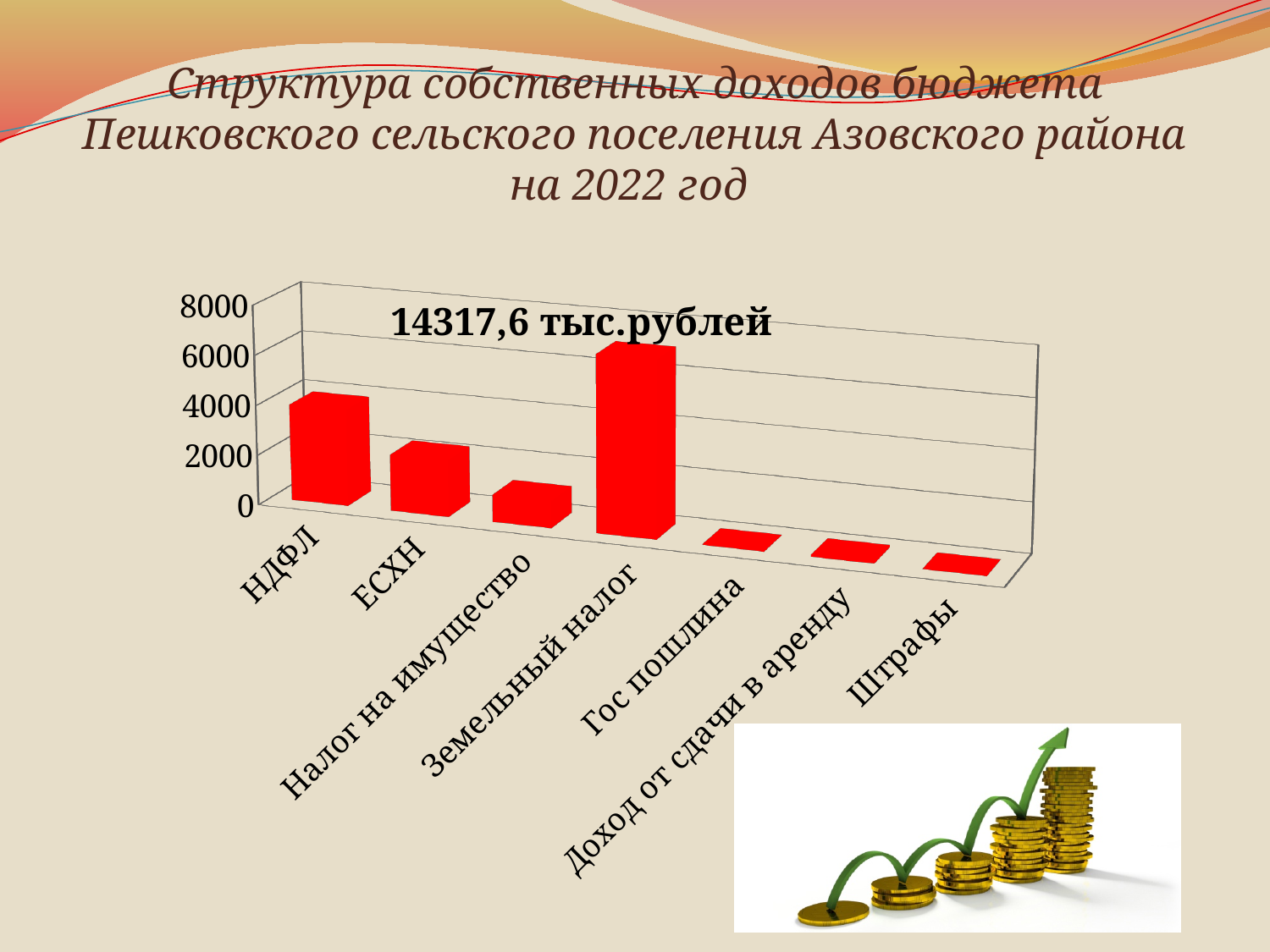
Which is larger, the value for Земельный налог or the value for НДФЛ? Земельный налог Is the value for НДФЛ greater or less than 2000? greater Is the value for Земельный налог greater or less than 4000? greater How many categories are shown on the x axis of the chart? 7 Which is larger, the value for НДФЛ or the value for ЕСХН? НДФЛ Is the value for ЕСХН greater or less than 4000? less What is the highest value shown on the vertical axis of the chart? 8000 What kind of chart is shown on the slide? bar chart What total amount is printed as a text label inside the chart area? 14317,6 тыс.рублей Which category has the highest value in the chart? Земельный налог